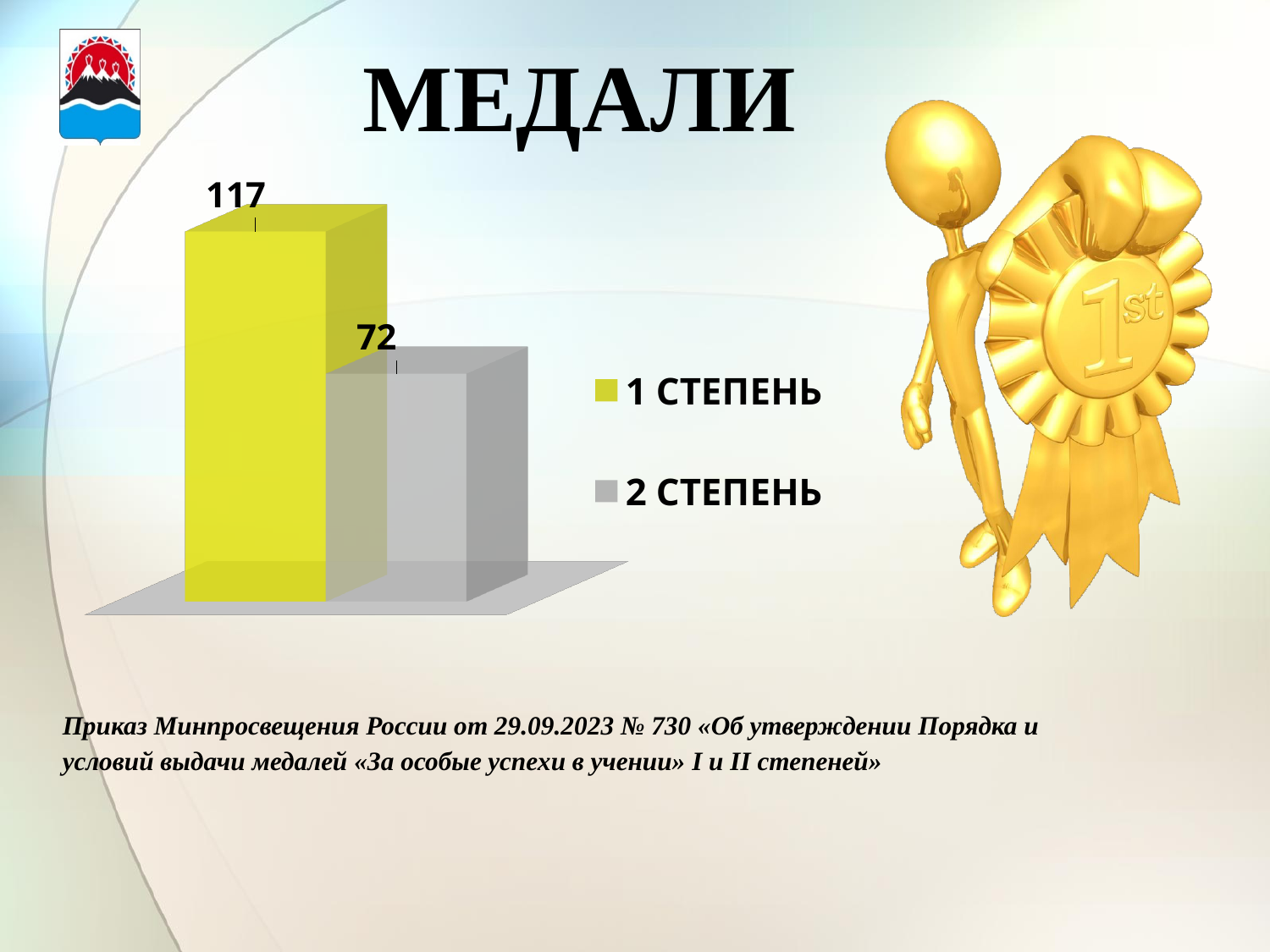
What is the value for 1 СТЕПЕНЬ? 117 What is the title shown above the chart? МЕДАЛИ Which is larger, the value for 1 СТЕПЕНЬ or the value for 2 СТЕПЕНЬ? 1 СТЕПЕНЬ Which series has the highest value? 1 СТЕПЕНЬ Which series has the lowest value? 2 СТЕПЕНЬ How many series does the legend list? 2 What is the difference between the values for 1 СТЕПЕНЬ and 2 СТЕПЕНЬ? 45 What kind of chart is shown on the slide? bar chart How many bars are plotted on the chart? 2 What is the value for 2 СТЕПЕНЬ? 72 What colour is the bar for 1 СТЕПЕНЬ? yellow What is the total of the two bars on the chart? 189